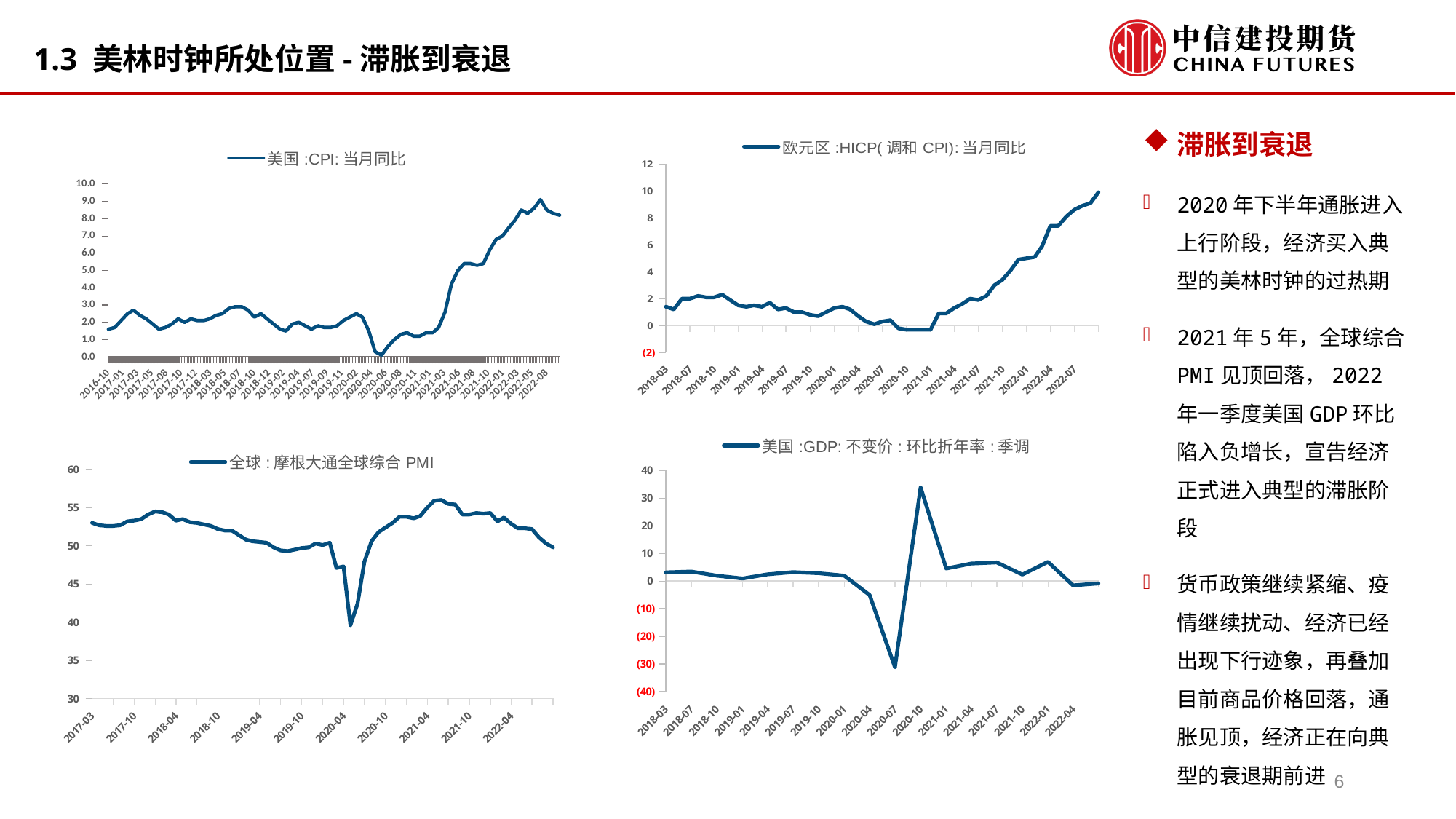
In the top-right chart (欧元区:HICP(调和CPI):当月同比), is the last plotted value greater or less than 8? greater In the top-right chart (欧元区:HICP(调和CPI):当月同比), is the value at 2018-03 greater or less than 2? less What kind of chart is the top-left chart titled 美国:CPI:当月同比? line chart How many series does the legend of the top-right chart (欧元区:HICP(调和CPI):当月同比) list? 1 In the bottom-right chart (美国:GDP:不变价:环比折年率:季调), is the peak value around 2020-10 greater or less than 30? greater What is the legend entry of the bottom-right chart? 美国:GDP:不变价:环比折年率:季调 In the top-right chart (欧元区:HICP(调和CPI):当月同比), do the values generally rise or fall from 2021-01 to the end of the series? rise How many charts are shown on the slide? 4